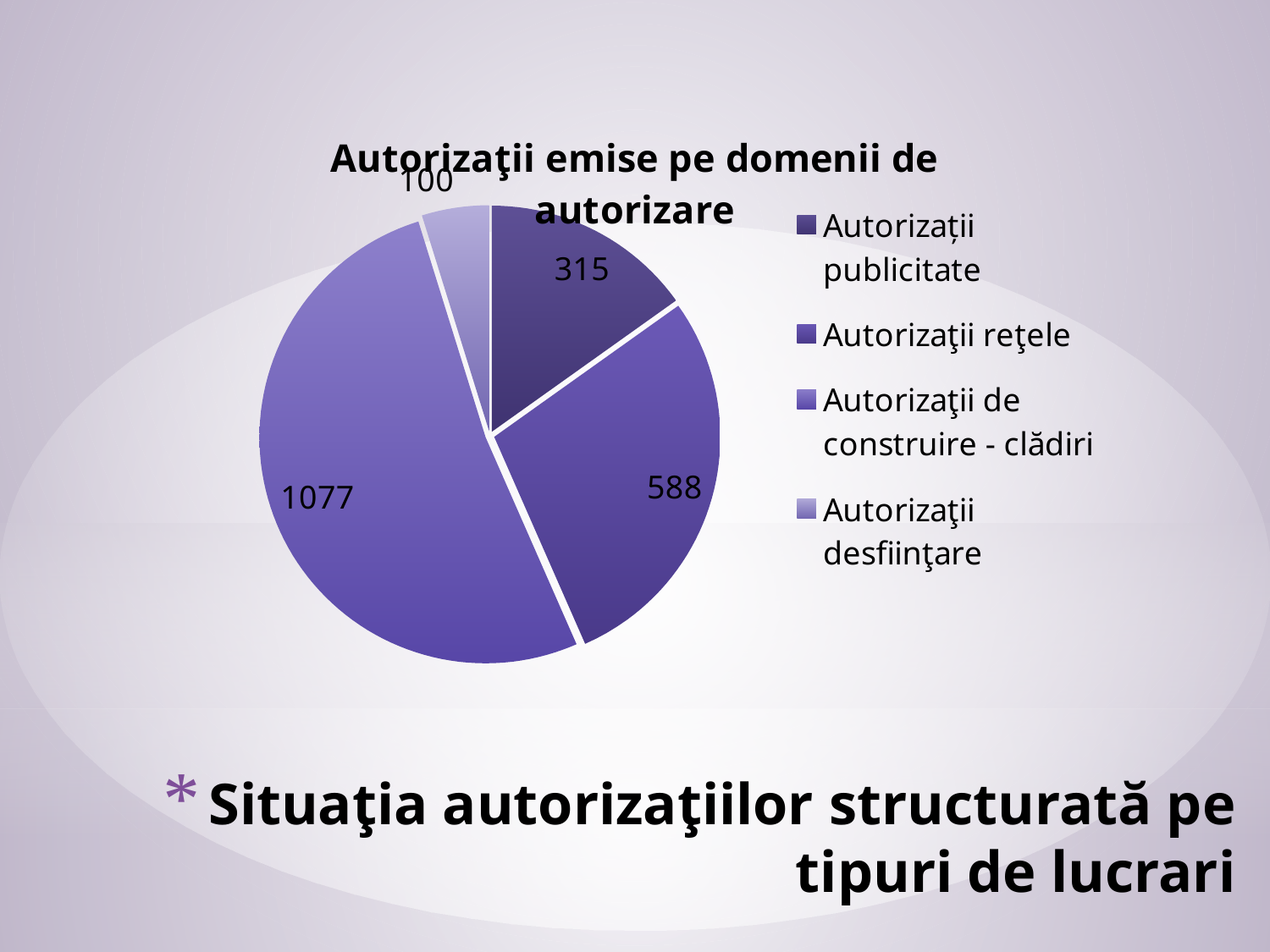
Which category has the largest slice? Autorizaţii de construire - clădiri What is the difference between the values for Autorizaţii de construire - clădiri and Autorizaţii reţele? 489 What is the title of the chart? Autorizaţii emise pe domenii de autorizare What type of chart is shown on the slide? Pie chart What is the value for Autorizații publicitate? 315 What is the value for Autorizaţii desfiinţare? 100 Which category has the smallest slice? Autorizaţii desfiinţare What is the value for Autorizaţii reţele? 588 What is the value for Autorizaţii de construire - clădiri? 1077 How many slices does the pie chart have? 4 Which is larger, the value for Autorizaţii reţele or the value for Autorizații publicitate? Autorizaţii reţele How many entries does the legend list? 4